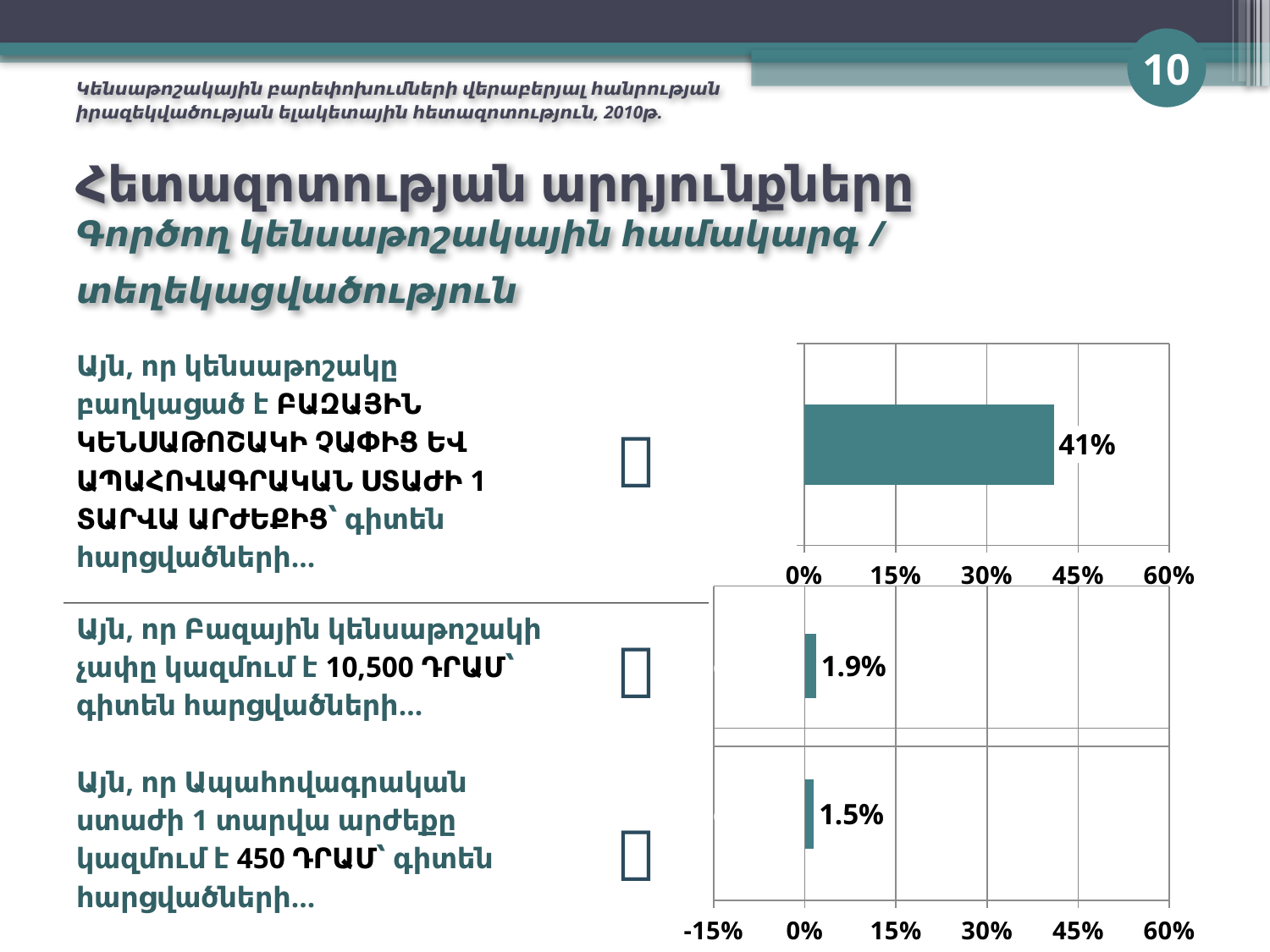
What is the difference between the top chart's bar (41%) and the bottom chart's upper bar (1.9%)? 39.1 percentage points Across all bars on the slide, which has the highest value? The top chart's bar, 41% Is the value of the bar in the top chart greater or less than 45%? less Across all bars on the slide, which has the lowest value? The bottom chart's lower bar, 1.5% In the bottom chart on the right, what value is printed on the lower bar? 1.5% In the bottom chart on the right, what value is printed on the upper bar? 1.9% What kind of chart is shown on the right side of the slide? Bar chart What is the lowest tick label on the x axis of the bottom chart? -15% In the bottom chart, which bar is larger, the upper one (1.9%) or the lower one (1.5%)? The upper one (1.9%) In the top chart on the right, what value is printed on the bar? 41% In the bottom chart, what is the difference between the upper bar (1.9%) and the lower bar (1.5%)? 0.4 percentage points